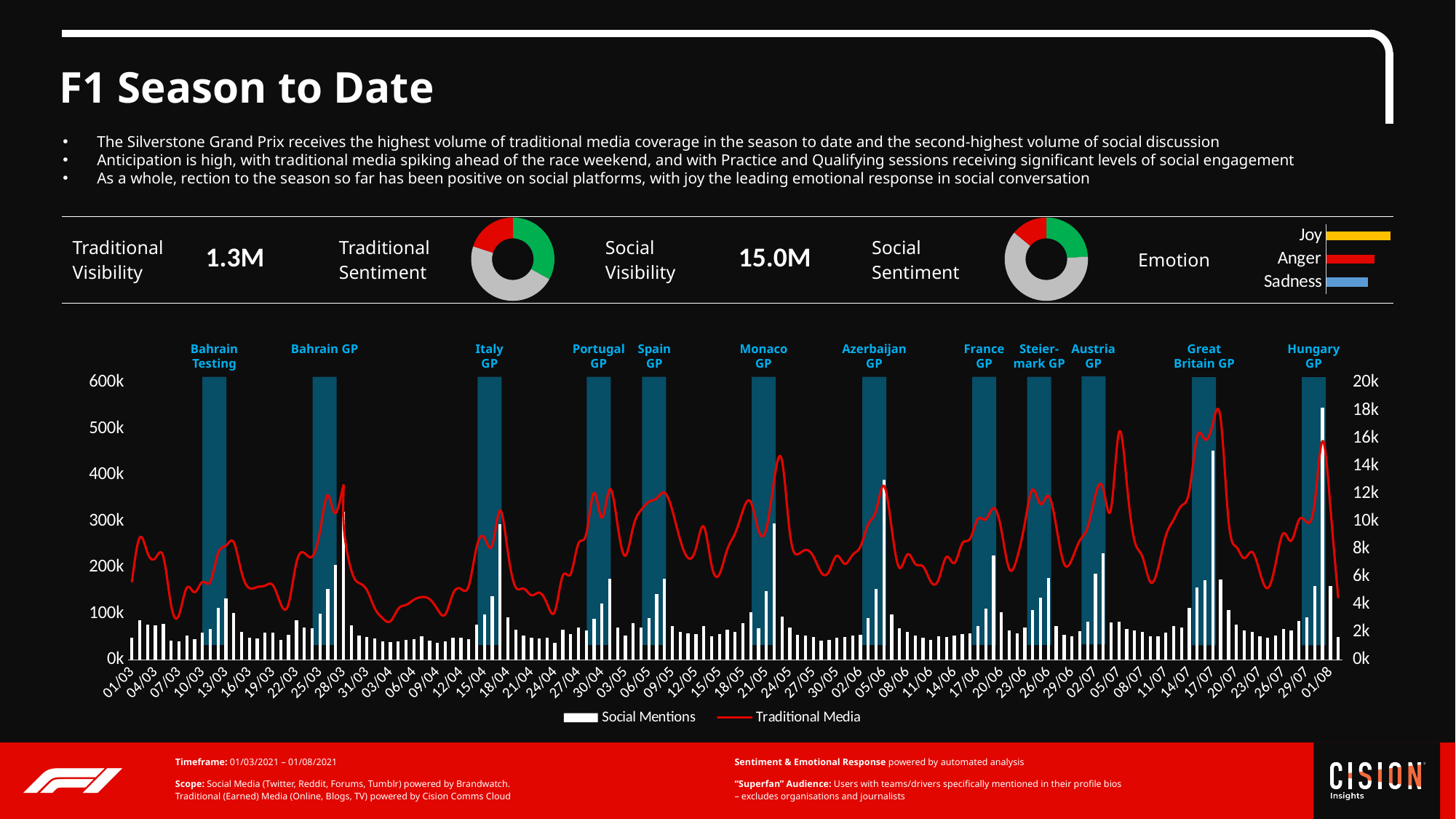
In the Emotion bar chart, which emotion has the shortest bar? Sadness How many series does the legend of the large chart list? 2 In the Social Sentiment donut chart, which colour segment is the smallest? Red What is the highest tick value shown on the left axis of the large chart? 600k In the large chart, is the tallest Social Mentions bar near the Hungary GP taller or shorter than the tallest bar near the Great Britain GP? Taller In the Emotion bar chart, which emotion has the longest bar? Joy In the large chart, near which labelled race does the Traditional Media line reach its highest peak? Great Britain GP What kind of chart is the large chart in the lower half of the slide? A combined bar and line chart How many emotions are shown in the Emotion bar chart? 3 In the large chart, how many race events are labelled above the highlighted columns? 12 What are the two series named in the legend of the large chart? Social Mentions and Traditional Media In the large chart, near which labelled race is the tallest Social Mentions bar? Hungary GP